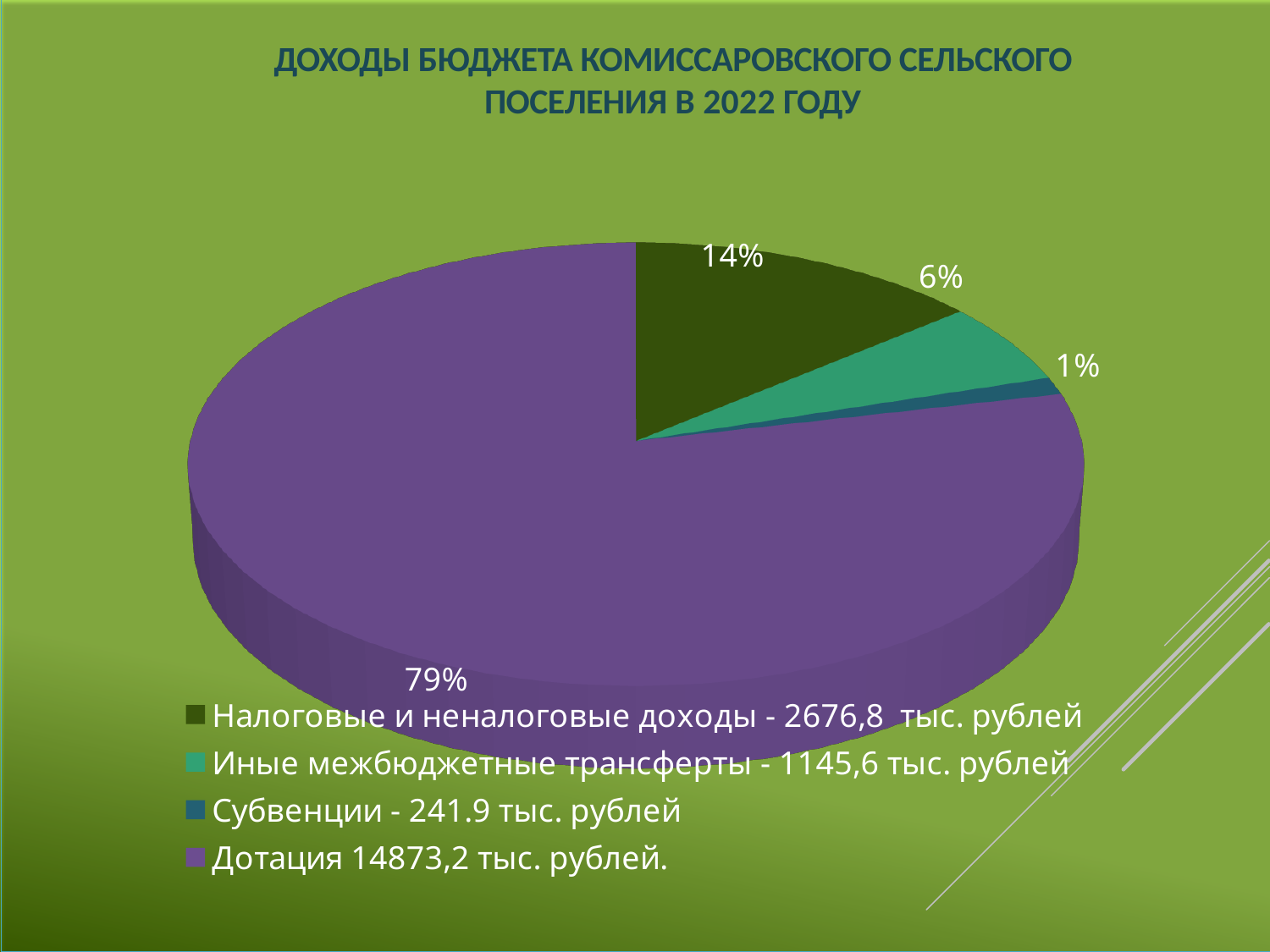
Which category has the largest slice of the pie? Дотация Which category has the smallest slice of the pie? Субвенции What share of the pie is labelled for Субвенции? 1% What share of the pie is labelled for Иные межбюджетные трансферты? 6% What share of the pie is labelled for Налоговые и неналоговые доходы? 14% How many entries does the legend list? 4 What kind of chart is shown on the slide? Pie chart How many slices does the pie chart have? 4 Which slice is larger: Иные межбюджетные трансферты or Субвенции? Иные межбюджетные трансферты What amount in тыс. рублей does the legend give for Субвенции? 241.9 тыс. рублей What is the difference in percentage points between the Дотация slice and the Налоговые и неналоговые доходы slice? 65 percentage points